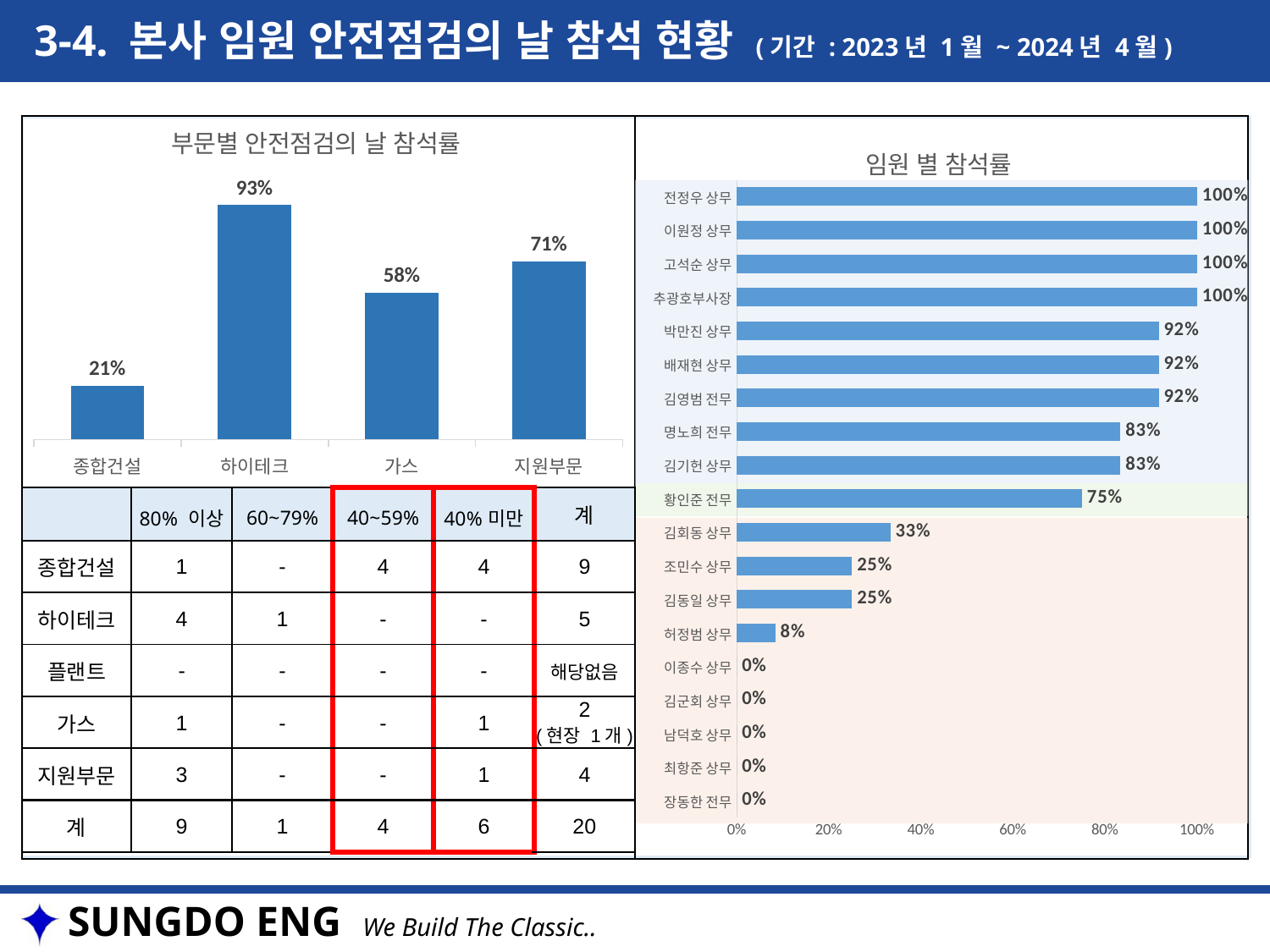
What kind of chart is the '부문별 안전점검의 날 참석률' chart? bar chart In the '부문별 안전점검의 날 참석률' chart, which category has the lowest value? 종합건설 In the '임원 별 참석률' chart, how many executives are listed? 19 In the '임원 별 참석률' chart, what is the value for 황인준 전무? 75% In the '부문별 안전점검의 날 참석률' chart, how many categories are shown? 4 In the '임원 별 참석률' chart, what is the value for 허정범 상무? 8% In the '부문별 안전점검의 날 참석률' chart, what is the value for 하이테크? 93% In the '부문별 안전점검의 날 참석률' chart, what is the difference between 지원부문 and 가스? 13% In the '임원 별 참석률' chart, which is larger, 김회동 상무 or 조민수 상무? 김회동 상무 In the '임원 별 참석률' chart, what is the difference between 박만진 상무 and 명노희 전무? 9% What is the title of the chart on the right side of the slide? 임원 별 참석률 In the '부문별 안전점검의 날 참석률' chart, what is the value for 종합건설? 21%